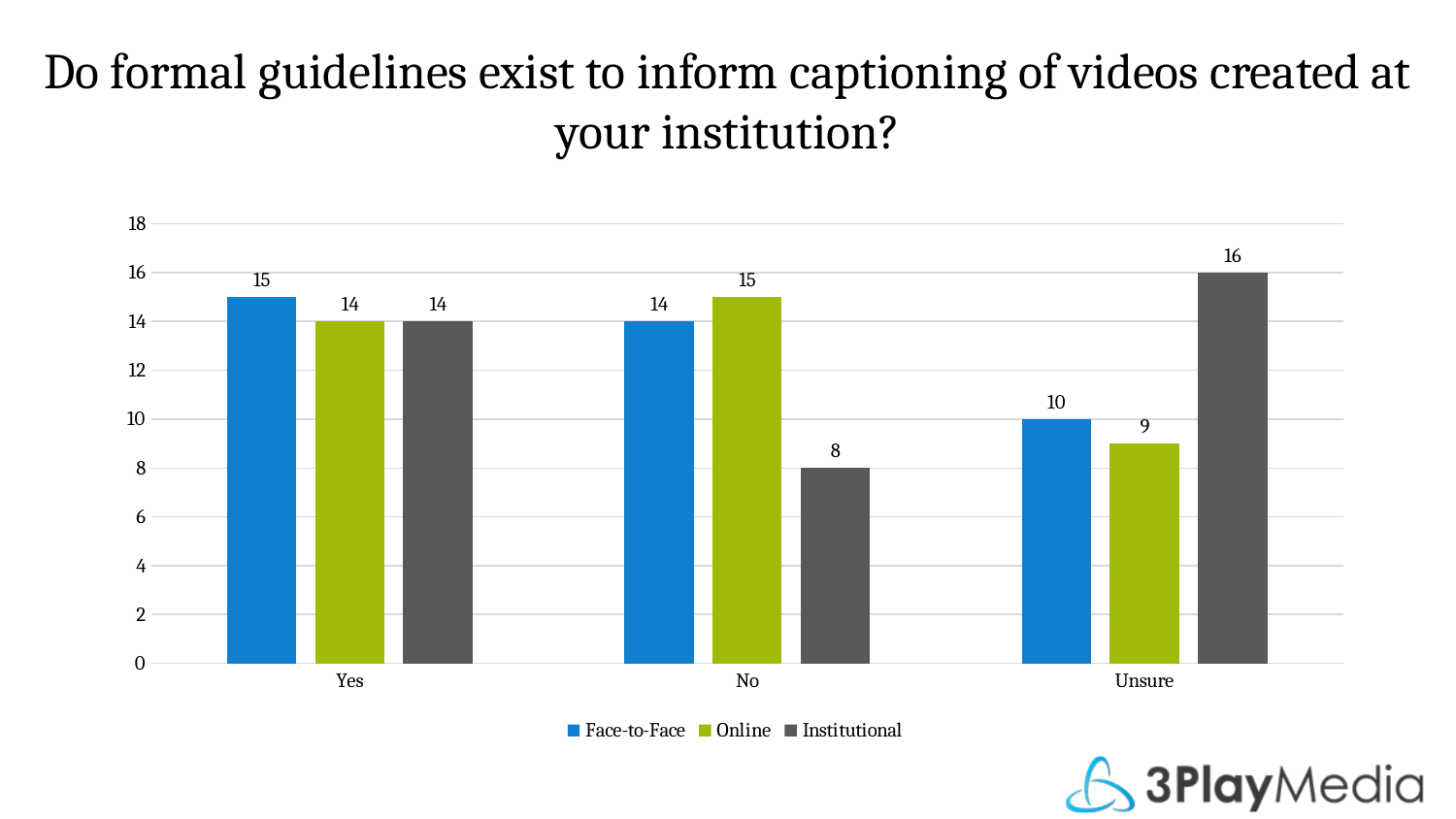
Is the value for Institutional in the Unsure category greater or less than 14? greater Which is larger: Face-to-Face for No or Face-to-Face for Unsure? Face-to-Face for No How many series does the legend list? 3 Which series has the highest value in the Unsure category? Institutional What is the value for Online in the Unsure category? 9 What is the value for Institutional in the No category? 8 Which series has the lowest value in the No category? Institutional What colour represents the Online series? Green What kind of chart is shown on the slide? Bar chart What is the difference between the Institutional values for Unsure and No? 8 What is the value for Face-to-Face in the Yes category? 15 How many categories are shown on the x axis? 3